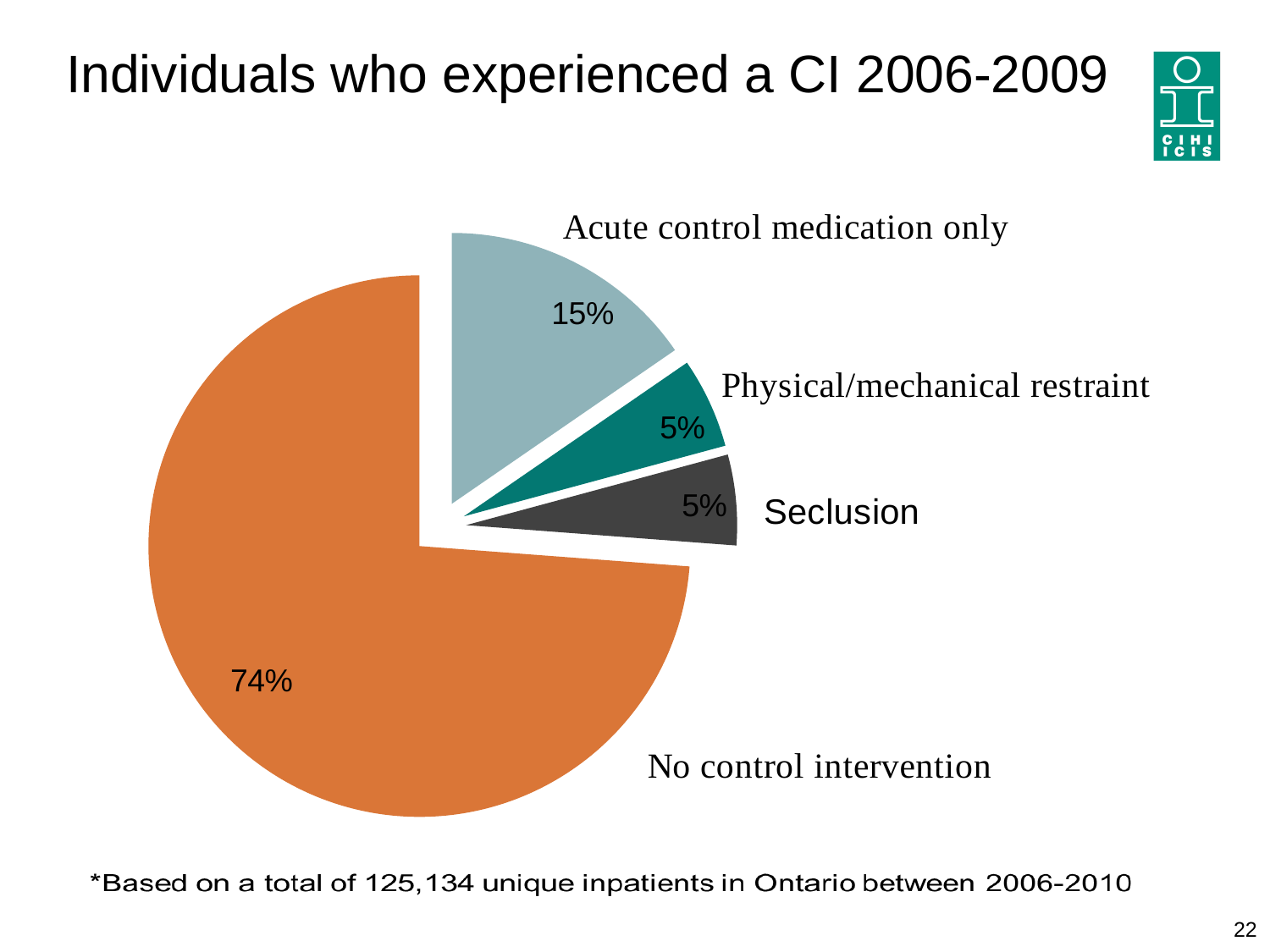
What is the difference in percentage points between 'No control intervention' and 'Acute control medication only'? 59 What percentage of individuals received acute control medication only? 15% What percentage of individuals experienced physical/mechanical restraint? 5% How many slices does the pie chart have? 4 What is the title of the chart on the slide? Individuals who experienced a CI 2006-2009 Which category has the largest slice of the pie? No control intervention What is the difference in percentage points between 'Acute control medication only' and 'Seclusion'? 10 What share of individuals had no control intervention? 74% What kind of chart is shown on the slide? Pie chart What colour is the 'No control intervention' slice? Orange Which is larger: the share for 'Acute control medication only' or the share for 'Physical/mechanical restraint'? Acute control medication only What percentage of individuals experienced seclusion? 5%